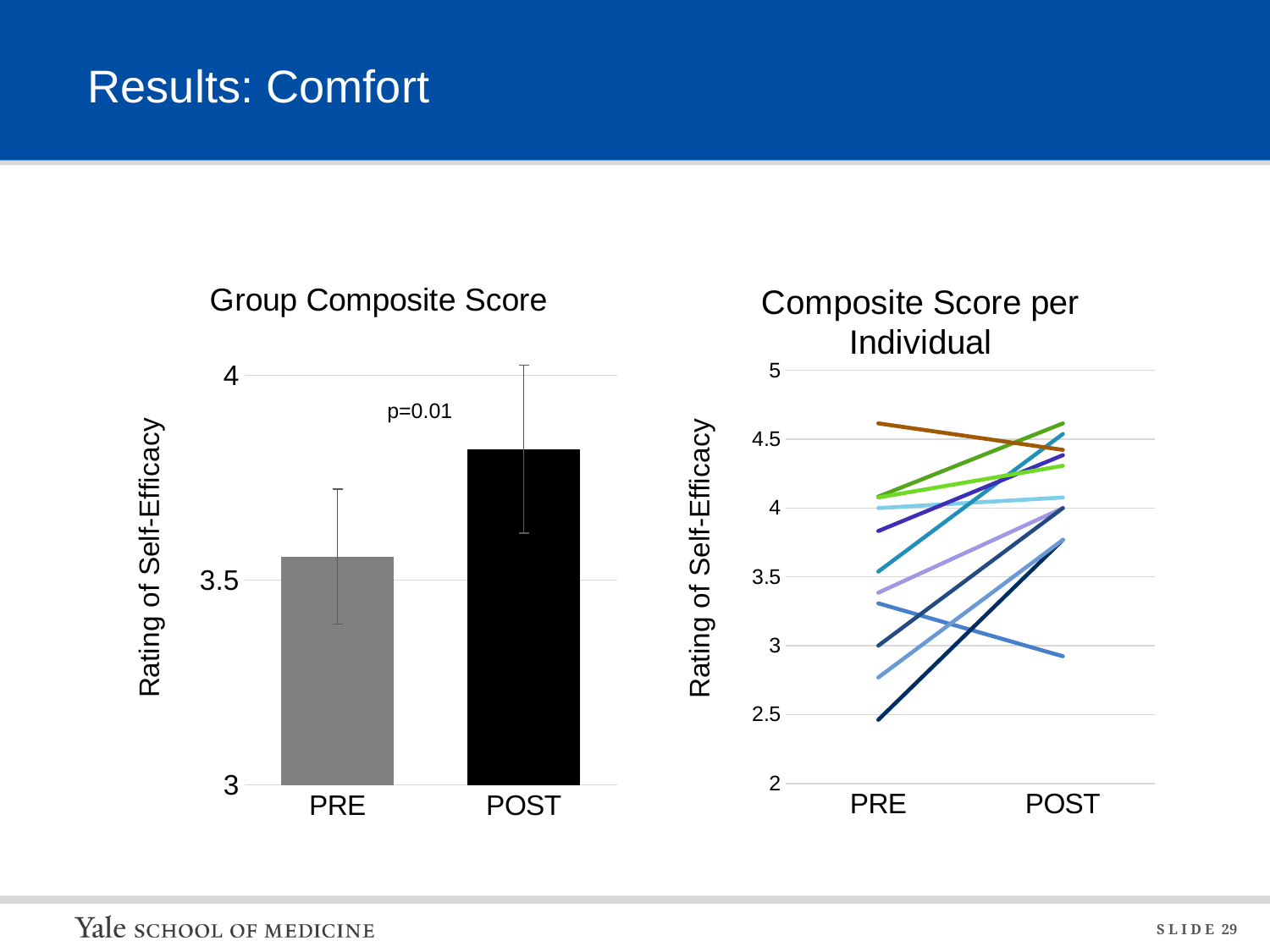
What kind of chart is the 'Composite Score per Individual' chart? line chart What is the y-axis label of the 'Composite Score per Individual' chart? Rating of Self-Efficacy In the 'Group Composite Score' chart, is the value for POST greater or less than 3.5? greater In the 'Group Composite Score' chart, is the value for POST greater or less than 4? less In the 'Group Composite Score' chart, which category has the lowest rating? PRE What p-value is printed on the 'Group Composite Score' chart? p=0.01 How many x-axis categories does the 'Composite Score per Individual' chart have? 2 What kind of chart is the 'Group Composite Score' chart? bar chart In the 'Composite Score per Individual' chart, is the lowest PRE value greater or less than 3? less How many categories are shown on the x axis of the 'Group Composite Score' chart? 2 In the 'Group Composite Score' chart, which category has the higher rating, PRE or POST? POST In the 'Composite Score per Individual' chart, do most of the individual lines rise or fall from PRE to POST? rise